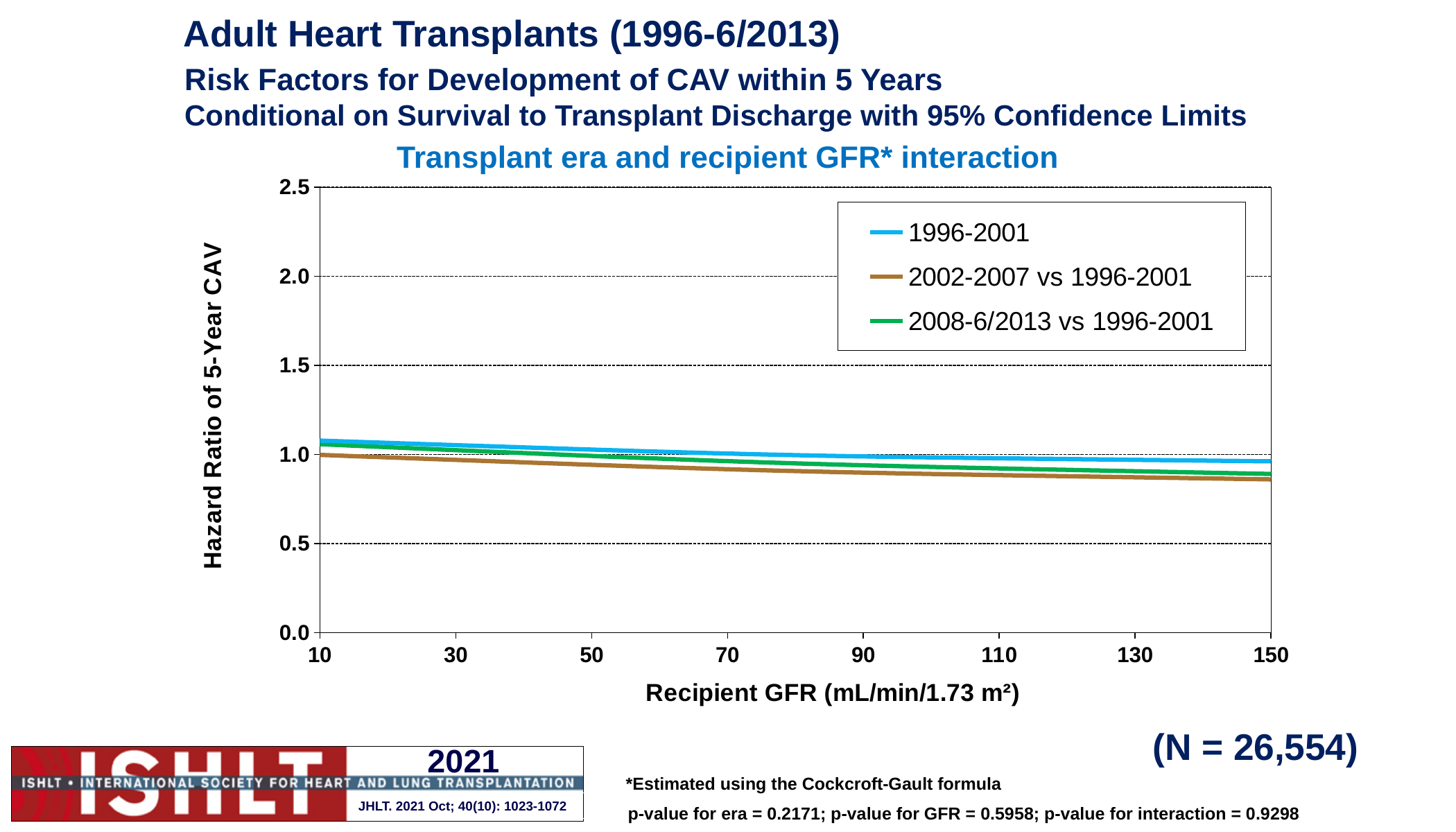
Is the hazard ratio for the 1996-2001 series greater or less than 1.5 across the whole GFR range? less Does the hazard ratio for the 2002-2007 vs 1996-2001 series rise or fall as recipient GFR increases? fall What is the label of the y axis? Hazard Ratio of 5-Year CAV How many series does the legend list? 3 What kind of chart is shown on the slide? line chart At a recipient GFR of 150, is the hazard ratio for 2002-2007 vs 1996-2001 greater or less than 1.0? less What is the title of the chart? Transplant era and recipient GFR* interaction At a recipient GFR of 150, which is larger: the hazard ratio for 1996-2001 or for 2002-2007 vs 1996-2001? 1996-2001 Does the hazard ratio for the 1996-2001 series rise or fall as recipient GFR increases? fall Which series is lowest at a recipient GFR of 150? 2002-2007 vs 1996-2001 Which series is highest at a recipient GFR of 150? 1996-2001 At a recipient GFR of 150, is the hazard ratio for 2008-6/2013 vs 1996-2001 greater or less than 1.0? less